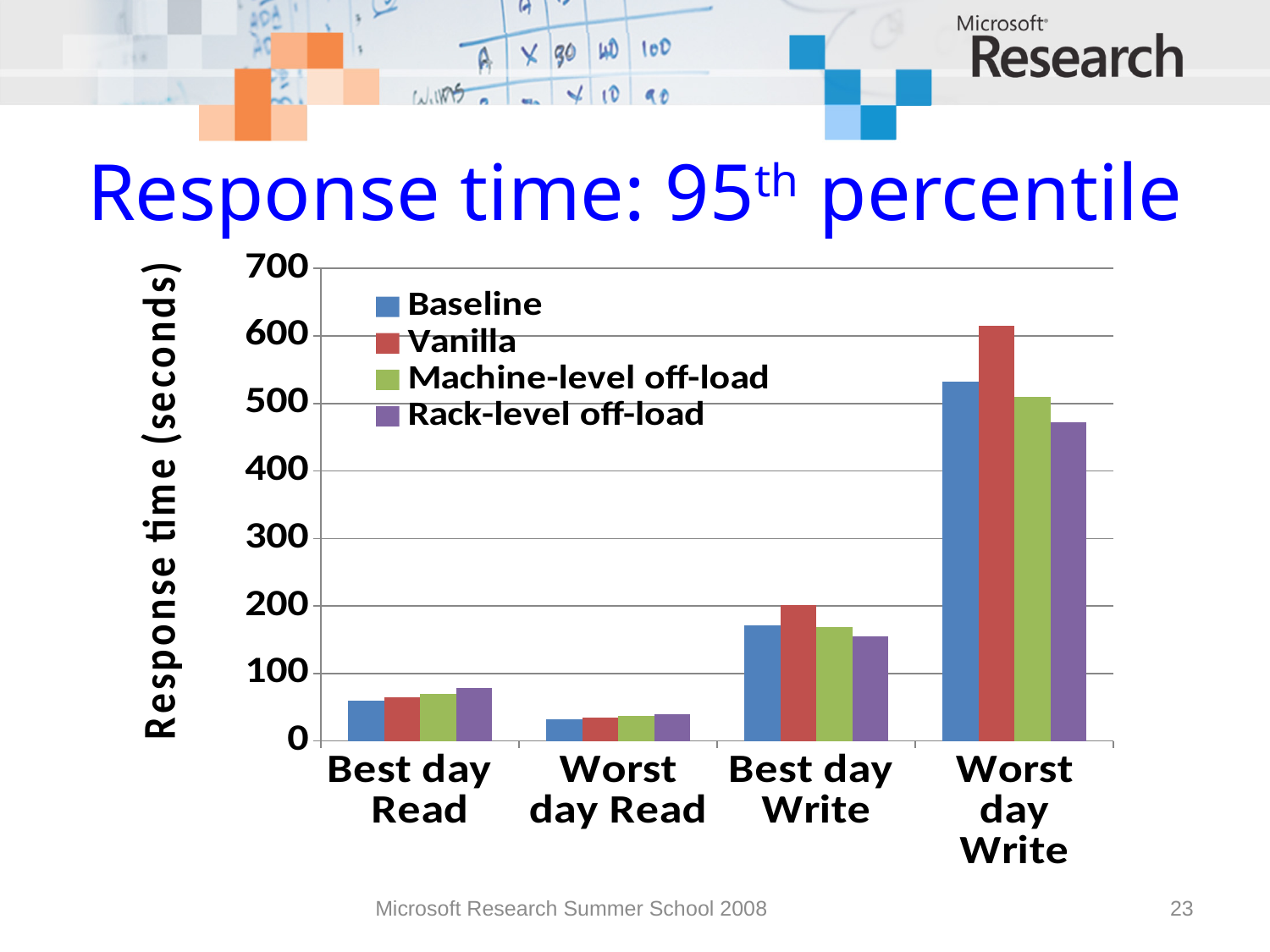
How many series does the legend list? 4 Is the Baseline value for Best day Write greater or less than 200? less Is the Vanilla value for Worst day Write greater or less than 600? greater What kind of chart is shown on the slide? bar chart In the Worst day Write category, which is larger: Vanilla or Rack-level off-load? Vanilla How many categories are shown on the x axis? 4 What is the label on the y axis? Response time (seconds) Which category has the highest Vanilla response time? Worst day Write Which category has the lowest Baseline response time? Worst day Read Which series has the highest bar in the Worst day Write category? Vanilla Is the Baseline value for Best day Read greater or less than 100? less